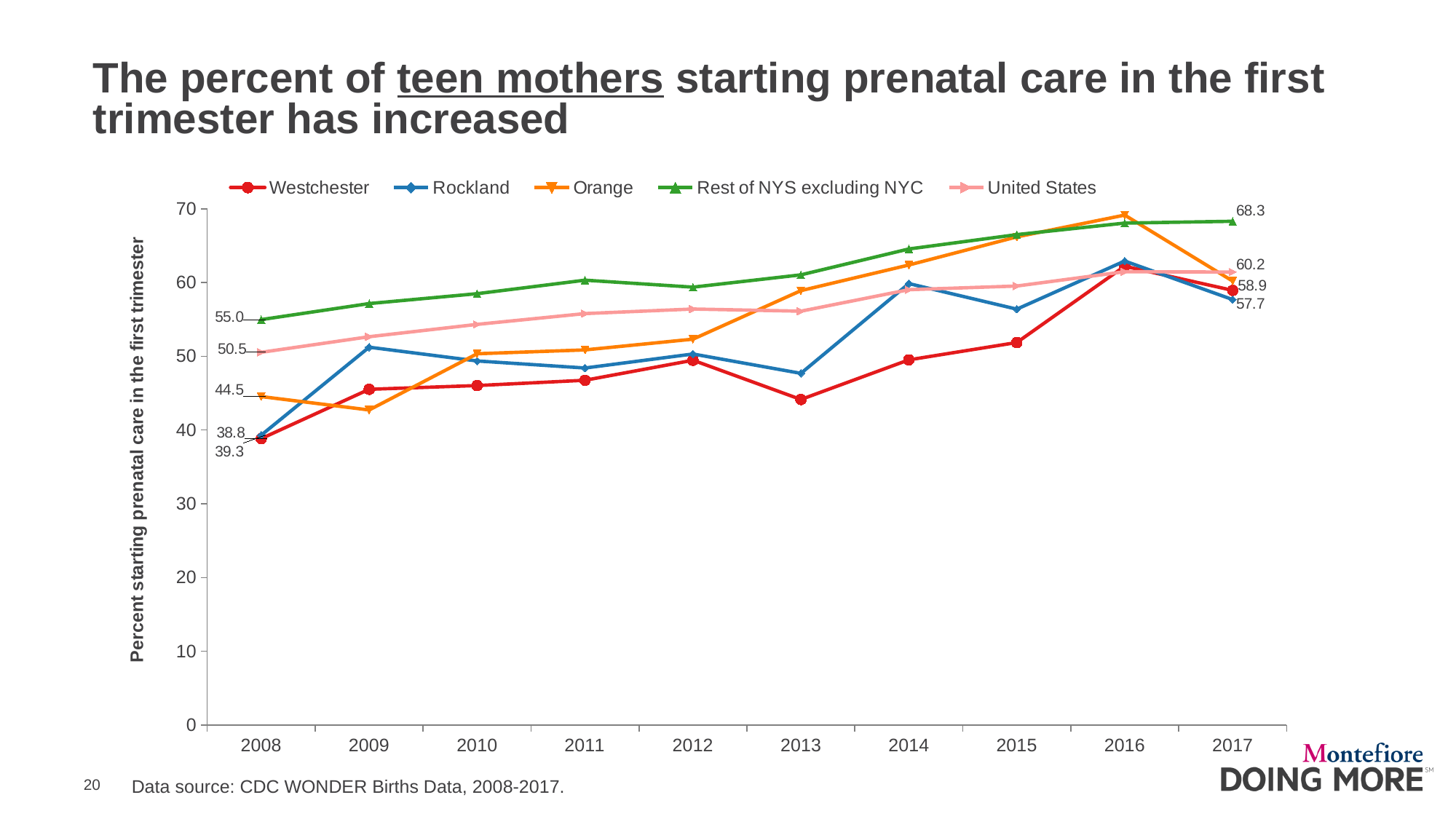
Is the value for Westchester in 2013 greater or less than 50? less What is the value for Rockland in 2017? 57.7 What kind of chart is shown on the slide? Line chart What is the value for Orange in 2008? 44.5 Which series has the highest value in 2008? Rest of NYS excluding NYC How many years are plotted along the x axis? 10 What is the value for Rest of NYS excluding NYC in 2017? 68.3 What is the value for United States in 2008? 50.5 What is the value for Westchester in 2017? 58.9 By how much did the value for Rest of NYS excluding NYC increase from 2008 to 2017? 13.3 How many series does the legend list? 5 What is the value for Rest of NYS excluding NYC in 2008? 55.0